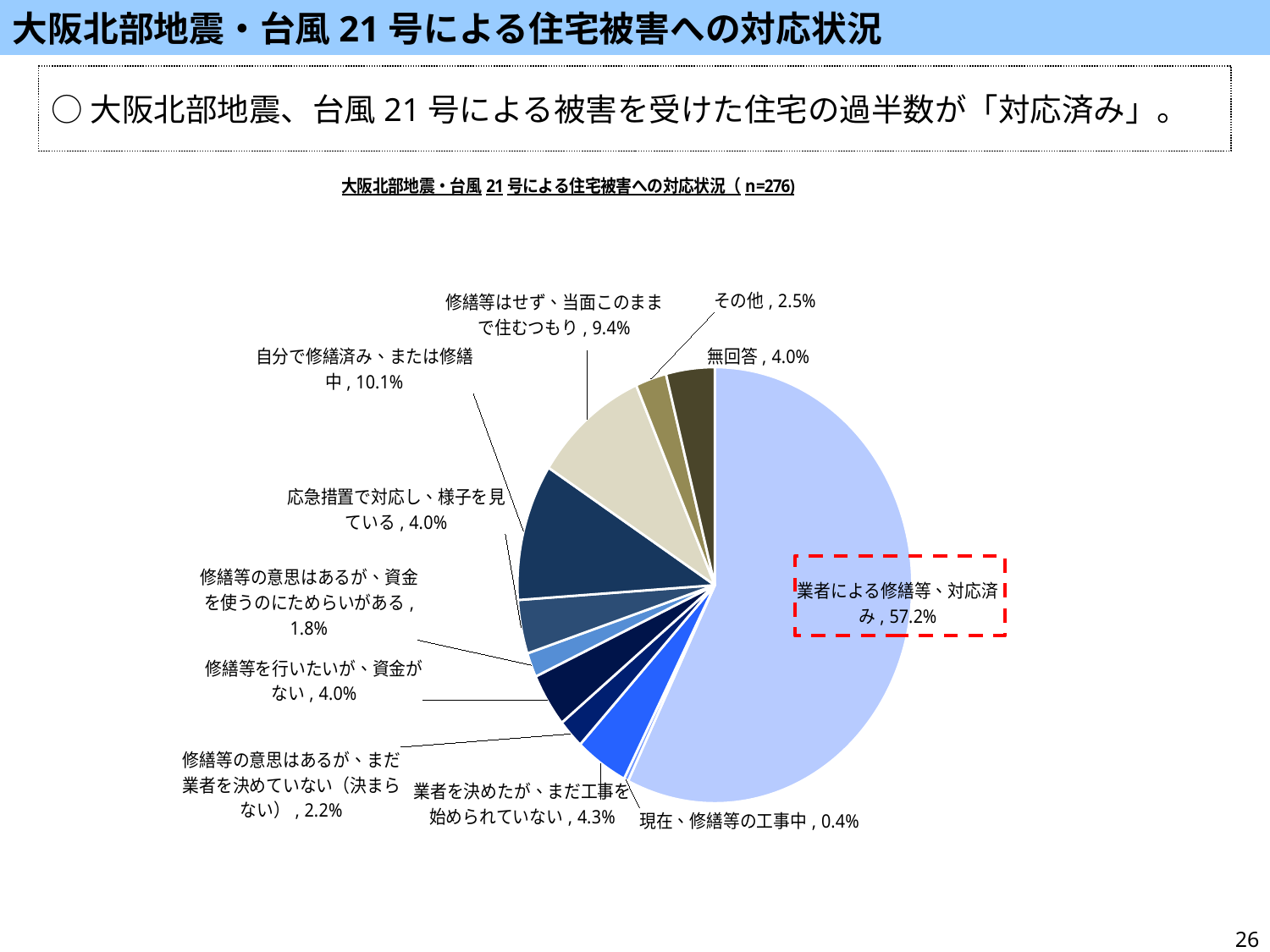
Which category has the smallest share of the pie? 現在、修繕等の工事中 What is the value for 「無回答」? 4.0% Which category has the largest share of the pie? 業者による修繕等、対応済み What is the value for 「自分で修繕済み、または修繕中」? 10.1% What is the value for 「修繕等はせず、当面このままで住むつもり」? 9.4% Which is larger, 「その他」 or 「修繕等の意思はあるが、まだ業者を決めていない（決まらない）」? その他 How many categories (slices) does the pie chart have? 11 What is the difference between 「自分で修繕済み、または修繕中」 and 「修繕等はせず、当面このままで住むつもり」? 0.7% What is the sample size (n) shown in the chart title? n=276 What kind of chart is shown on the slide? pie chart What percentage of respondents answered 「業者による修繕等、対応済み」? 57.2% What is the value for 「業者を決めたが、まだ工事を始められていない」? 4.3%